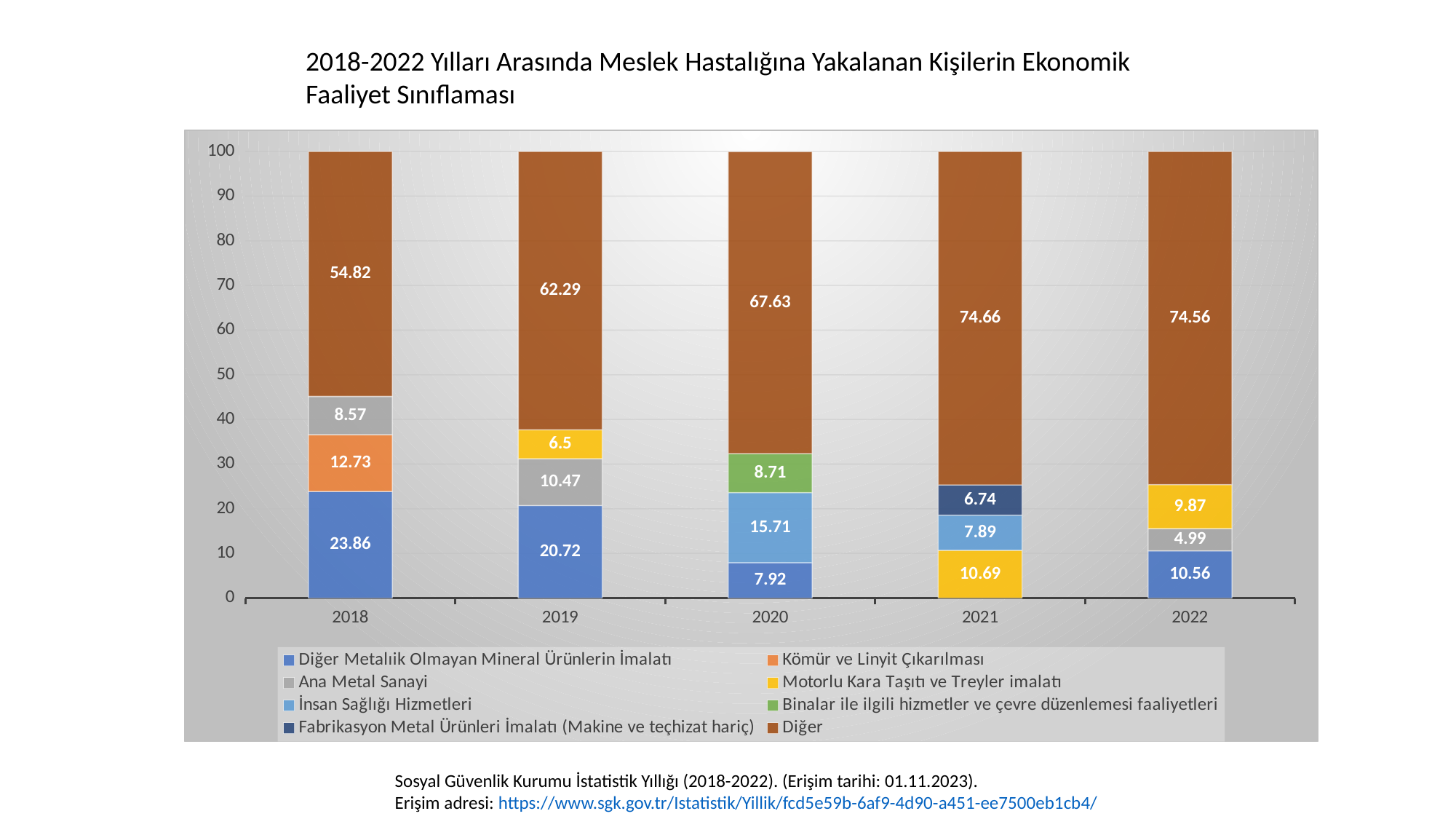
In which year is the value for Diğer the lowest? 2018 What is the value for Kömür ve Linyit Çıkarılması in 2018? 12.73 What is the value for Diğer in 2020? 67.63 How many series does the legend list? 8 What is the difference between the Diğer values for 2019 and 2018? 7.47 Does the value for Diğer Metalıik Olmayan Mineral Ürünlerin İmalatı rise or fall from 2018 to 2020? Fall Which year has the larger value for Ana Metal Sanayi, 2018 or 2019? 2019 What is the difference between the Motorlu Kara Taşıtı ve Treyler imalatı values for 2021 and 2022? 0.82 In which year is the value for Diğer the highest? 2021 What is the value for İnsan Sağlığı Hizmetleri in 2021? 7.89 How many years are shown on the x axis? 5 What kind of chart is shown on the slide? Stacked bar chart